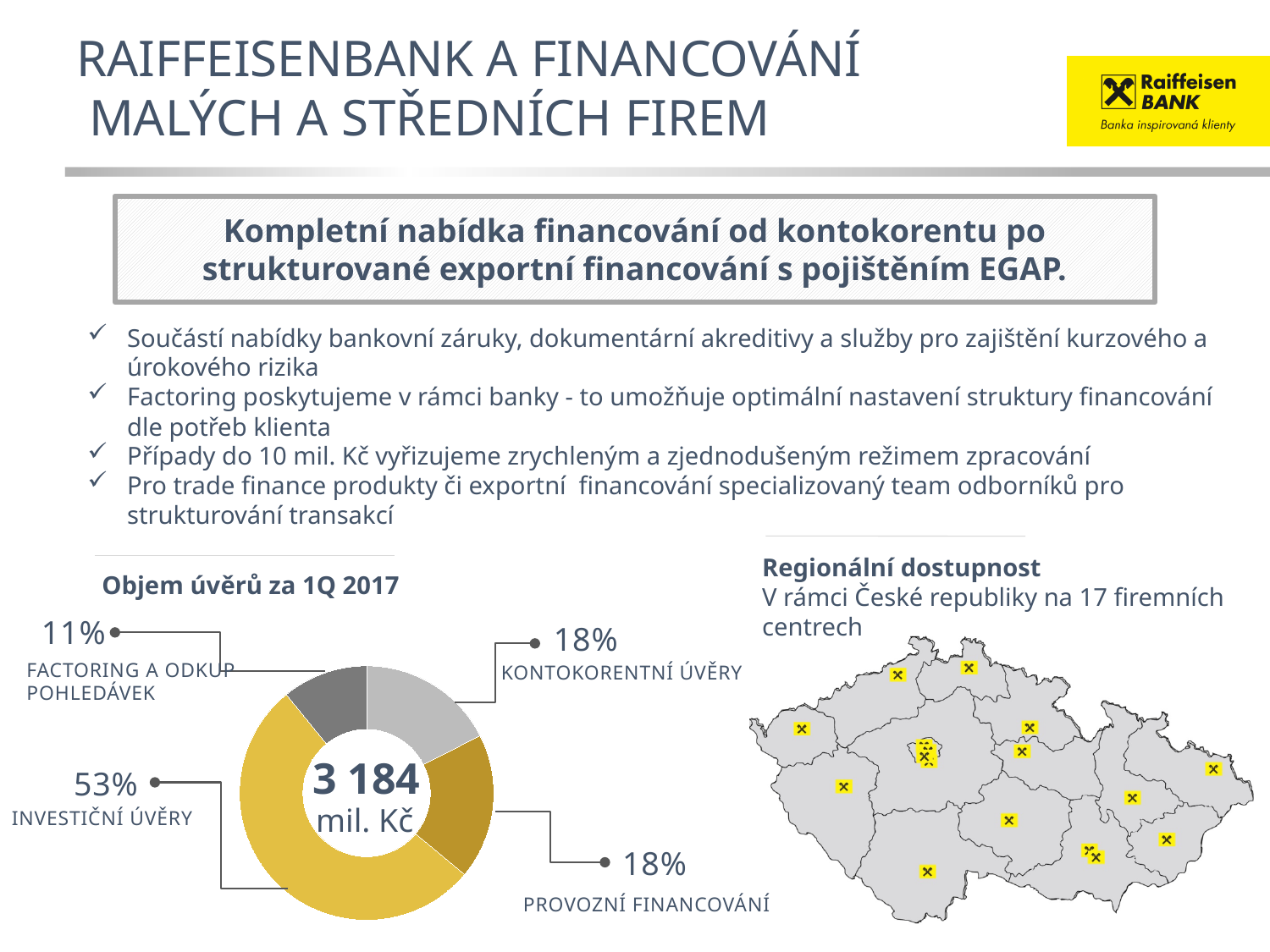
What total value is shown in the centre of the 'Objem úvěrů za 1Q 2017' chart? 3 184 mil. Kč In the 'Objem úvěrů za 1Q 2017' chart, which is larger: Investiční úvěry or Factoring a odkup pohledávek? Investiční úvěry What share of the loan volume in the 'Objem úvěrů za 1Q 2017' chart is Provozní financování? 18% What share of the loan volume in the 'Objem úvěrů za 1Q 2017' chart is Factoring a odkup pohledávek? 11% What kind of chart is 'Objem úvěrů za 1Q 2017'? Donut (pie) chart What is the title of the donut chart on the slide? Objem úvěrů za 1Q 2017 How many categories are shown in the 'Objem úvěrů za 1Q 2017' chart? 4 Which category has the smallest share in the 'Objem úvěrů za 1Q 2017' chart? Factoring a odkup pohledávek In the 'Objem úvěrů za 1Q 2017' chart, what is the difference in percentage points between Investiční úvěry and Kontokorentní úvěry? 35 percentage points What share of the loan volume in the 'Objem úvěrů za 1Q 2017' chart is Investiční úvěry? 53% Which category has the largest share in the 'Objem úvěrů za 1Q 2017' chart? Investiční úvěry What share of the loan volume in the 'Objem úvěrů za 1Q 2017' chart is Kontokorentní úvěry? 18%